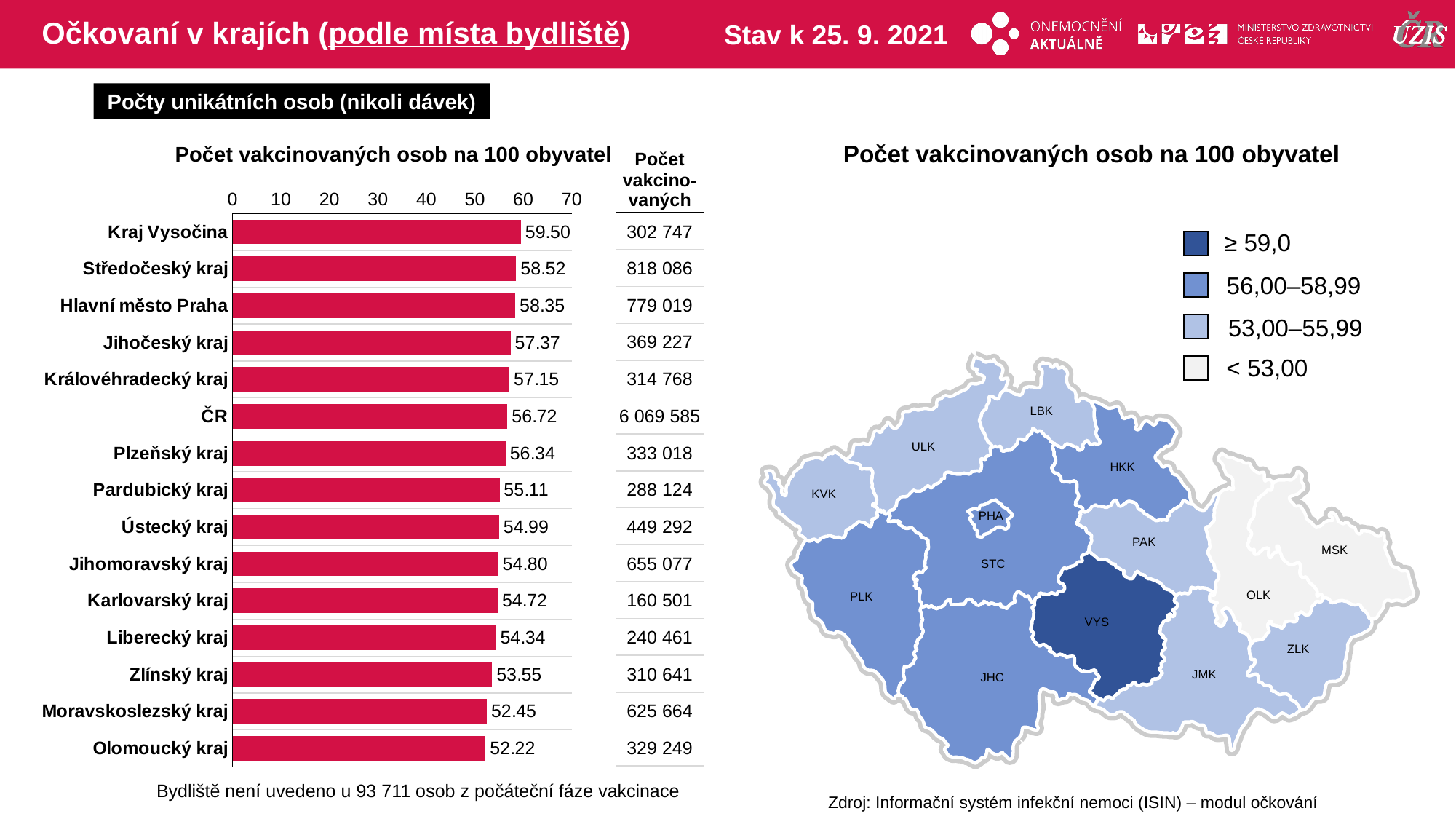
In the bar chart, what is the difference between the values for Kraj Vysočina and Olomoucký kraj? 7.28 In the bar chart, what is the value for ČR? 56.72 How many bars are shown in the bar chart? 15 In the bar chart, which category has the lowest value? Olomoucký kraj In the bar chart, which category has the highest value? Kraj Vysočina What kind of chart is used on the left of the slide to show the number of vaccinated persons per 100 inhabitants? bar chart In the bar chart, which has a larger value: Jihočeský kraj or Plzeňský kraj? Jihočeský kraj In the bar chart, what is the value for Olomoucký kraj? 52.22 In the bar chart, what is the value for Kraj Vysočina? 59.50 In the bar chart, do the values rise or fall going from the top bar to the bottom bar? fall In the bar chart, is the value for Moravskoslezský kraj greater or less than 60? less How many categories does the legend of the map on the right list? 4